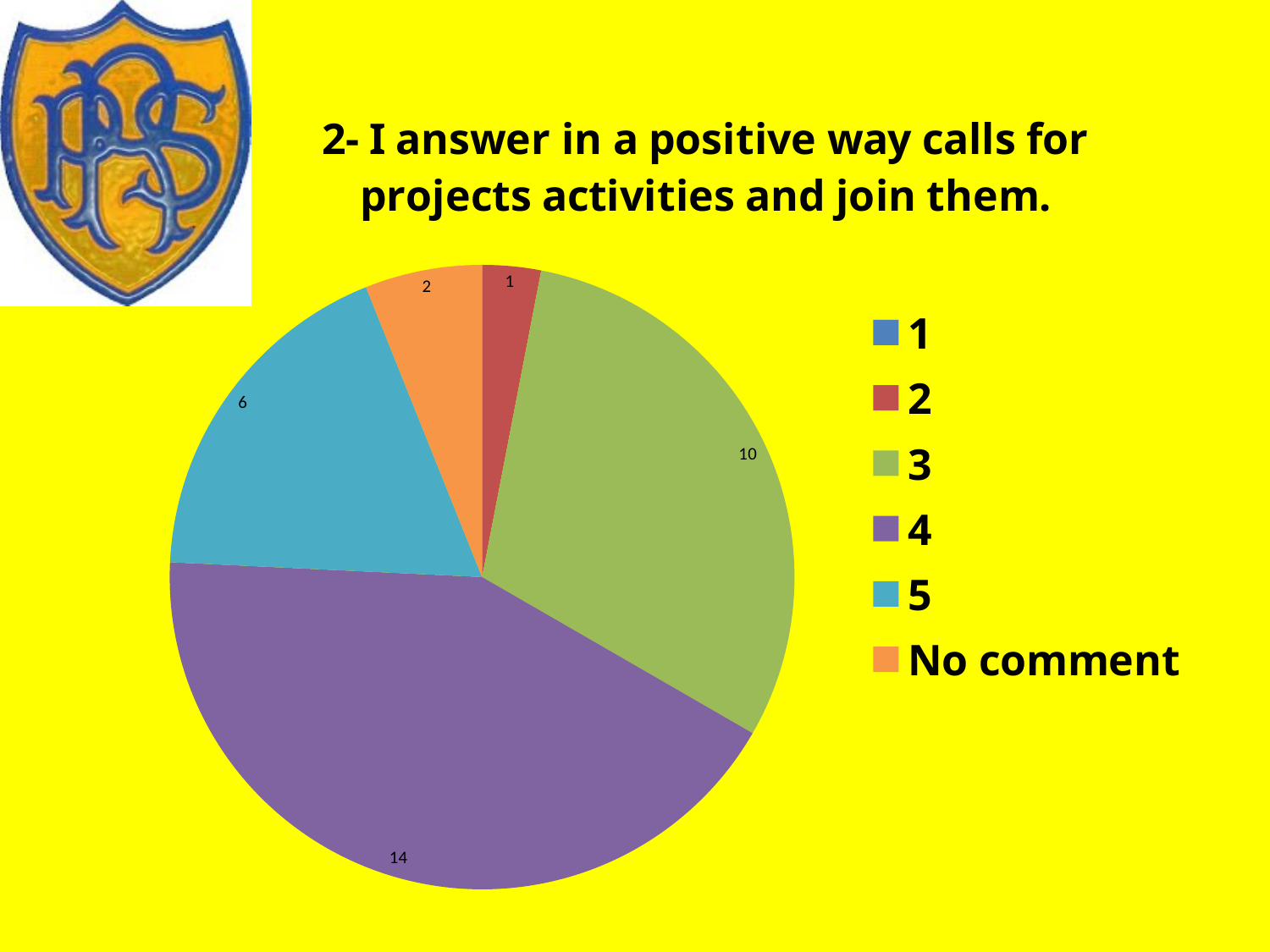
How many entries does the legend list? 6 What value is shown for the slice labelled 4? 14 What value is shown for the slice labelled 2? 1 Which category has the largest slice of the pie? 4 Which of the labelled slices is the smallest? 2 What is the difference between the values for category 4 and category 3? 4 What kind of chart is shown on the slide? pie chart What is the title of the chart? 2- I answer in a positive way calls for projects activities and join them. What value is shown for the slice labelled 3? 10 What value is shown for the slice labelled 5? 6 Which is larger, the value for category 5 or the value for category 3? 3 What value is shown for the No comment slice? 2